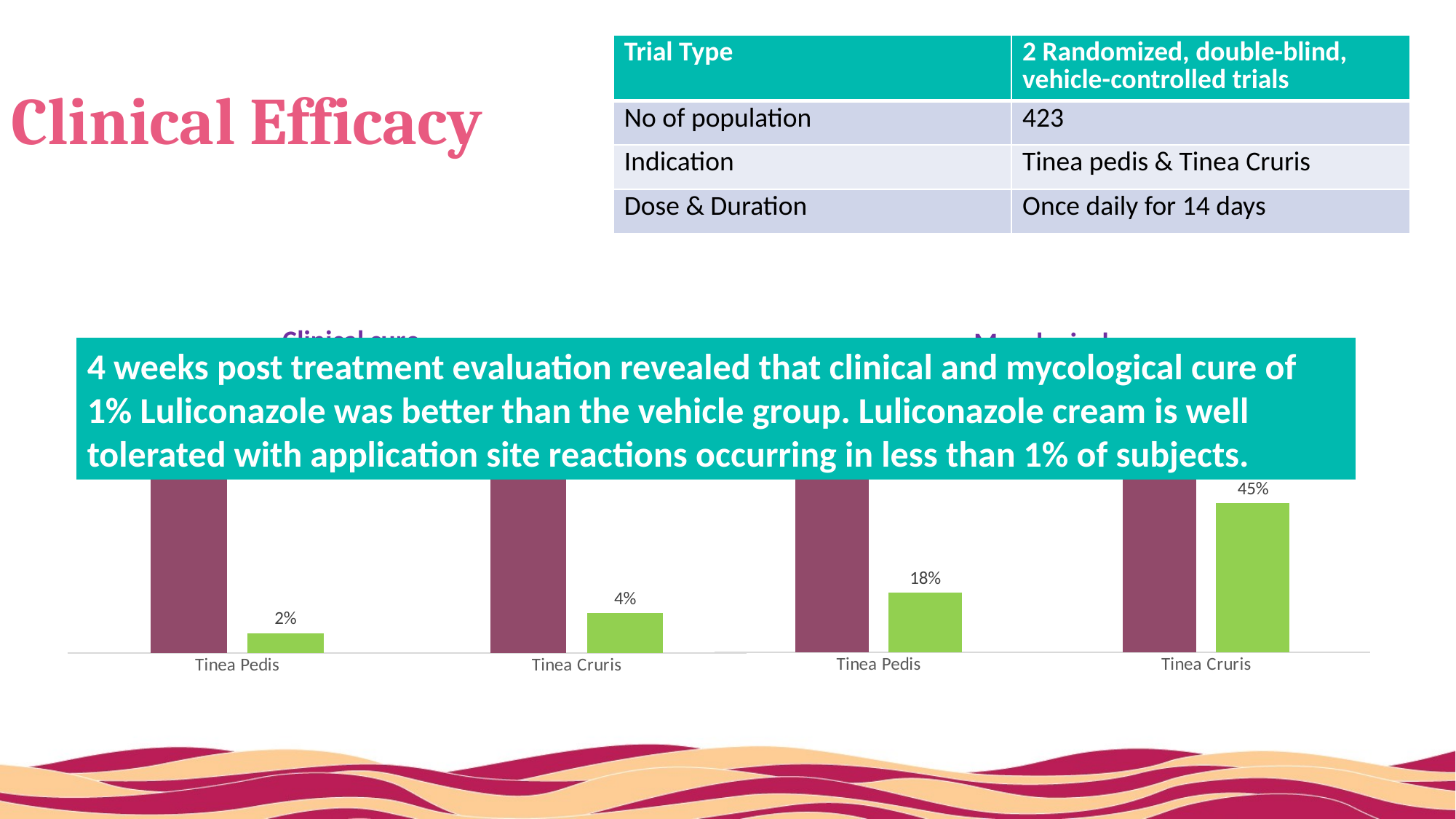
In the left chart, what value is labelled on the green bar for Tinea Cruris? 4% In the right chart, what value is labelled on the green bar for Tinea Cruris? 45% In the left chart, what is the difference between the green bar values for Tinea Cruris and Tinea Pedis? 2% In the left chart, which category has the lower green bar value? Tinea Pedis In the right chart, for Tinea Pedis, which bar is taller, the purple bar or the green bar? the purple bar In the right chart, what is the difference between the green bar values for Tinea Cruris and Tinea Pedis? 27% In the right chart, which category has the higher green bar value? Tinea Cruris How many categories are shown on the x axis of the left chart? 2 In the left chart, what value is labelled on the green bar for Tinea Pedis? 2% In the right chart, what value is labelled on the green bar for Tinea Pedis? 18% What kind of chart is the right chart? bar chart How many charts are shown on the slide? 2